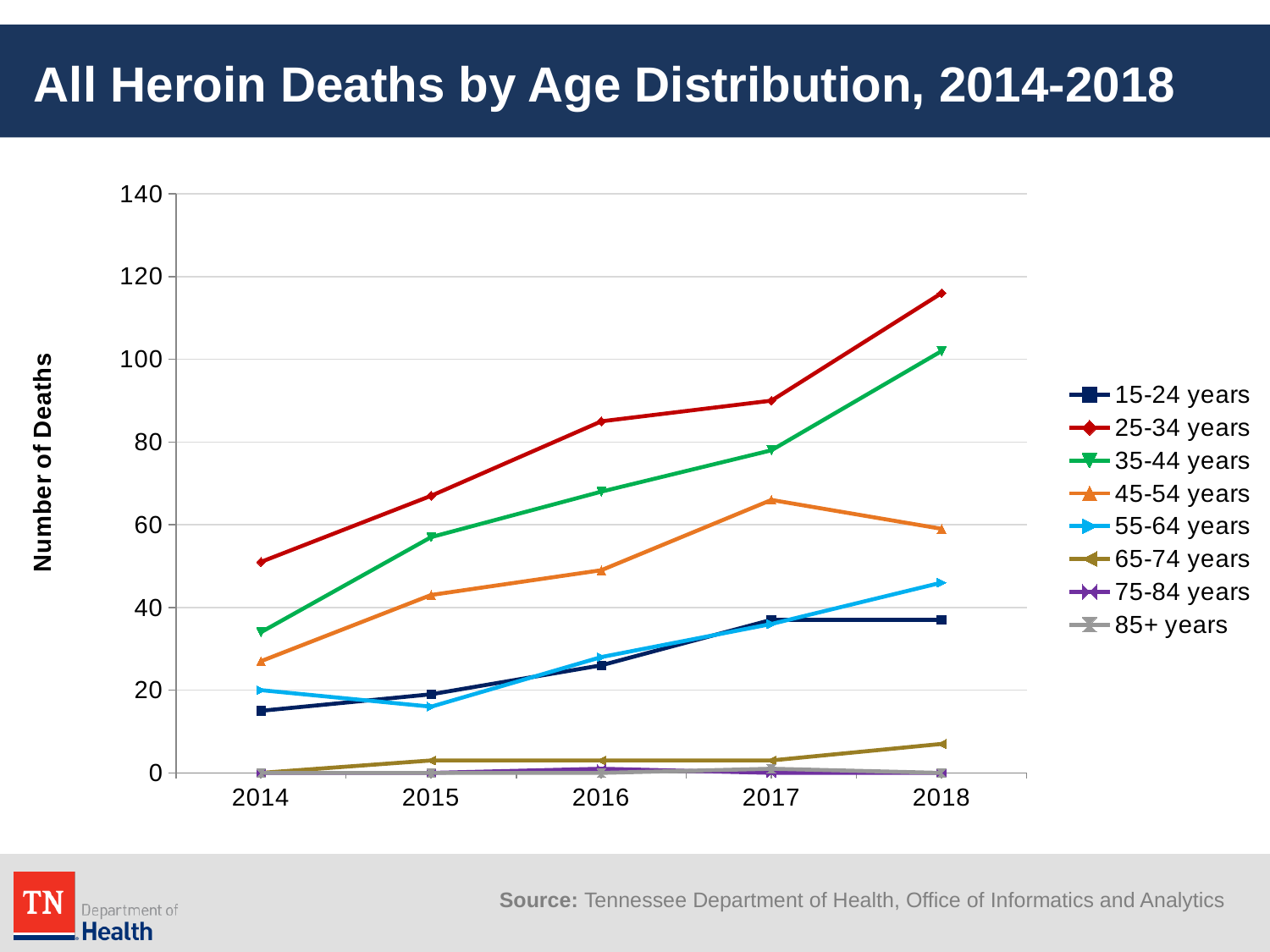
What type of chart is shown on the slide? line chart Do the deaths for the 25-34 years group rise or fall from 2014 to 2018? rise In 2017, which has more deaths: 45-54 years or 55-64 years? 45-54 years Is the value for 45-54 years in 2017 greater or less than 60? greater What is the label on the y axis? Number of Deaths Is the value for 25-34 years in 2018 greater or less than 100? greater Is the value for 35-44 years in 2014 greater or less than 40? less How many age groups does the legend list? 8 Do the deaths for the 45-54 years group rise or fall from 2017 to 2018? fall Which age group has the highest number of deaths in 2018? 25-34 years How many years are plotted along the x axis? 5